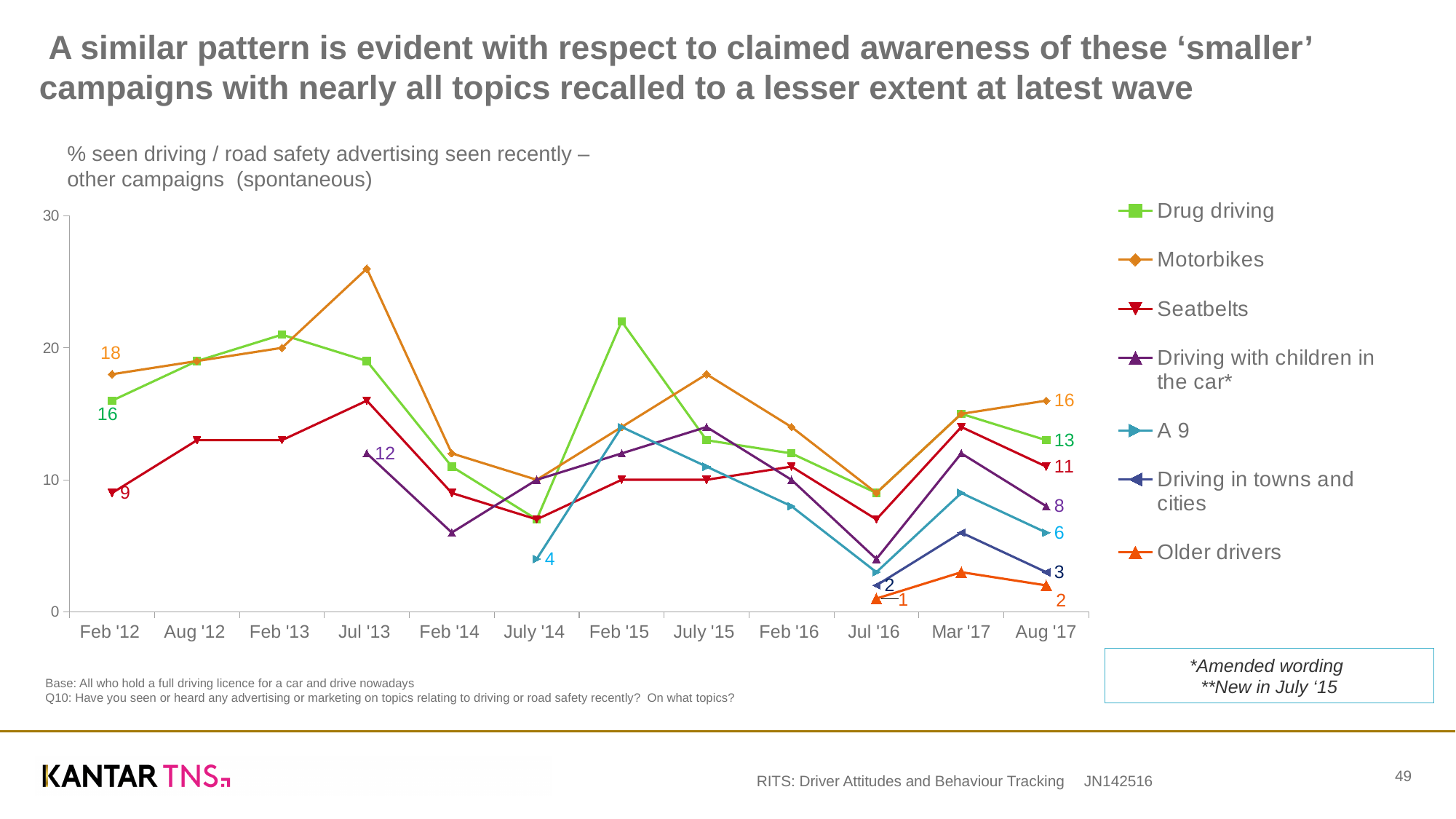
What is the value for A 9 at July '14? 4 Which series has the lowest value at Aug '17? Older drivers What is the difference between the Motorbikes value at Feb '12 and at Aug '17? 2 What kind of chart is shown on the slide? line chart What is the value for Older drivers at Jul '16? 1 Is the value for Motorbikes at Jul '13 greater or less than 20? greater What is the value for Motorbikes at Aug '17? 16 How many series does the legend list? 7 Which series has the highest value at Aug '17? Motorbikes What is the value for Drug driving at Feb '12? 16 How many time points are shown on the x axis? 12 At Aug '17, which is larger: Driving with children in the car or A 9? Driving with children in the car